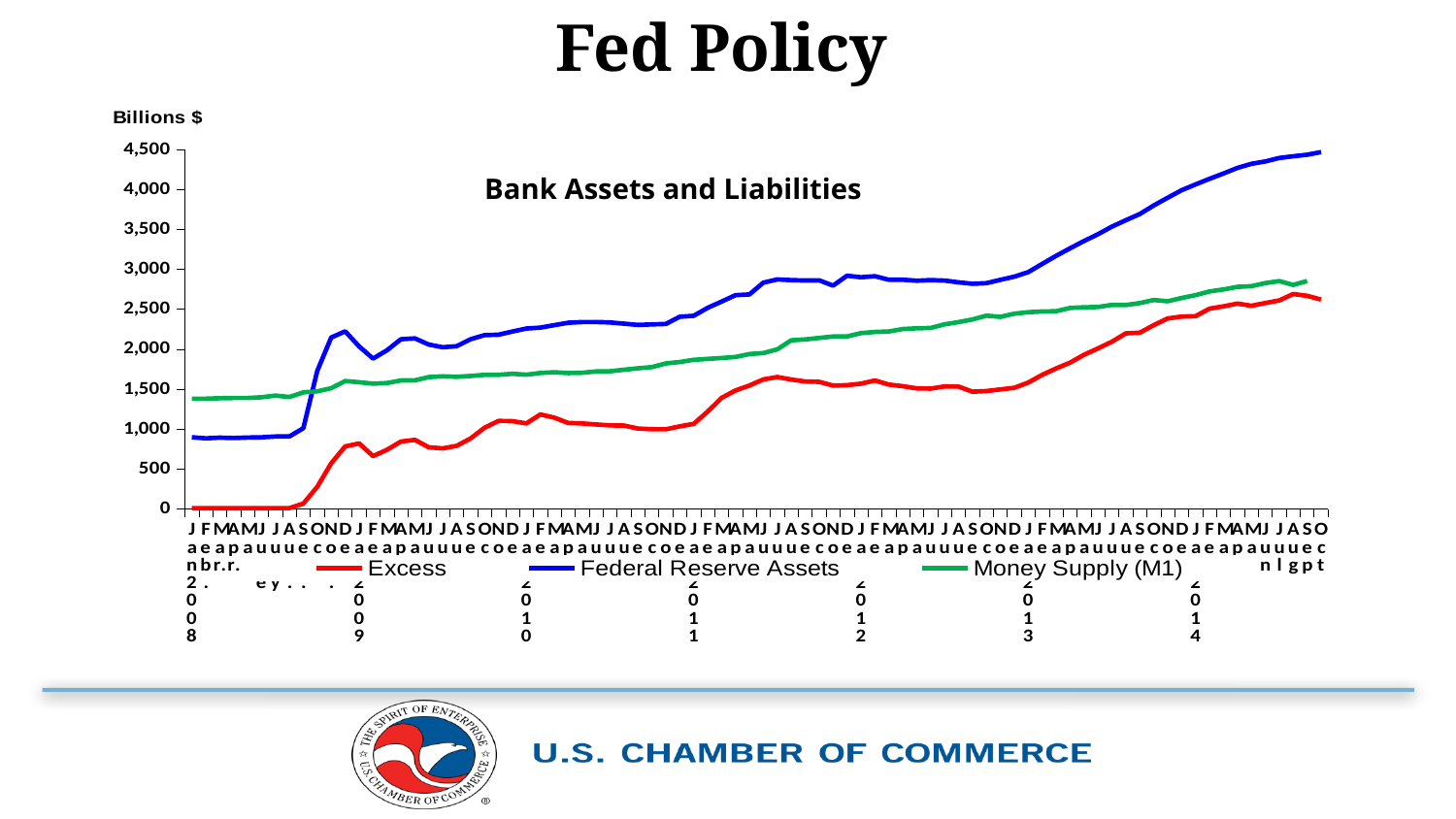
Is the value of Money Supply (M1) at the left end of the chart (Jan 2008) greater or less than 1,000? greater Does the Federal Reserve Assets line generally rise or fall from left to right across the chart? rise How many series does the legend of the chart list? 3 Is the value of Federal Reserve Assets at the right end of the chart greater or less than 4,000? greater Does the Money Supply (M1) line generally rise or fall from left to right across the chart? rise Is the value of Excess at the left end of the chart (Jan 2008) greater or less than 500? less What is the title printed inside the chart area? Bank Assets and Liabilities At the left end of the chart (Jan 2008), which is larger: Federal Reserve Assets or Money Supply (M1)? Money Supply (M1) Which series has the highest value at the right end of the chart (Oct 2014)? Federal Reserve Assets Which series has the lowest value at the left end of the chart (Jan 2008)? Excess What kind of chart is shown on the slide? line chart What are the series names listed in the chart's legend? Excess, Federal Reserve Assets, Money Supply (M1)